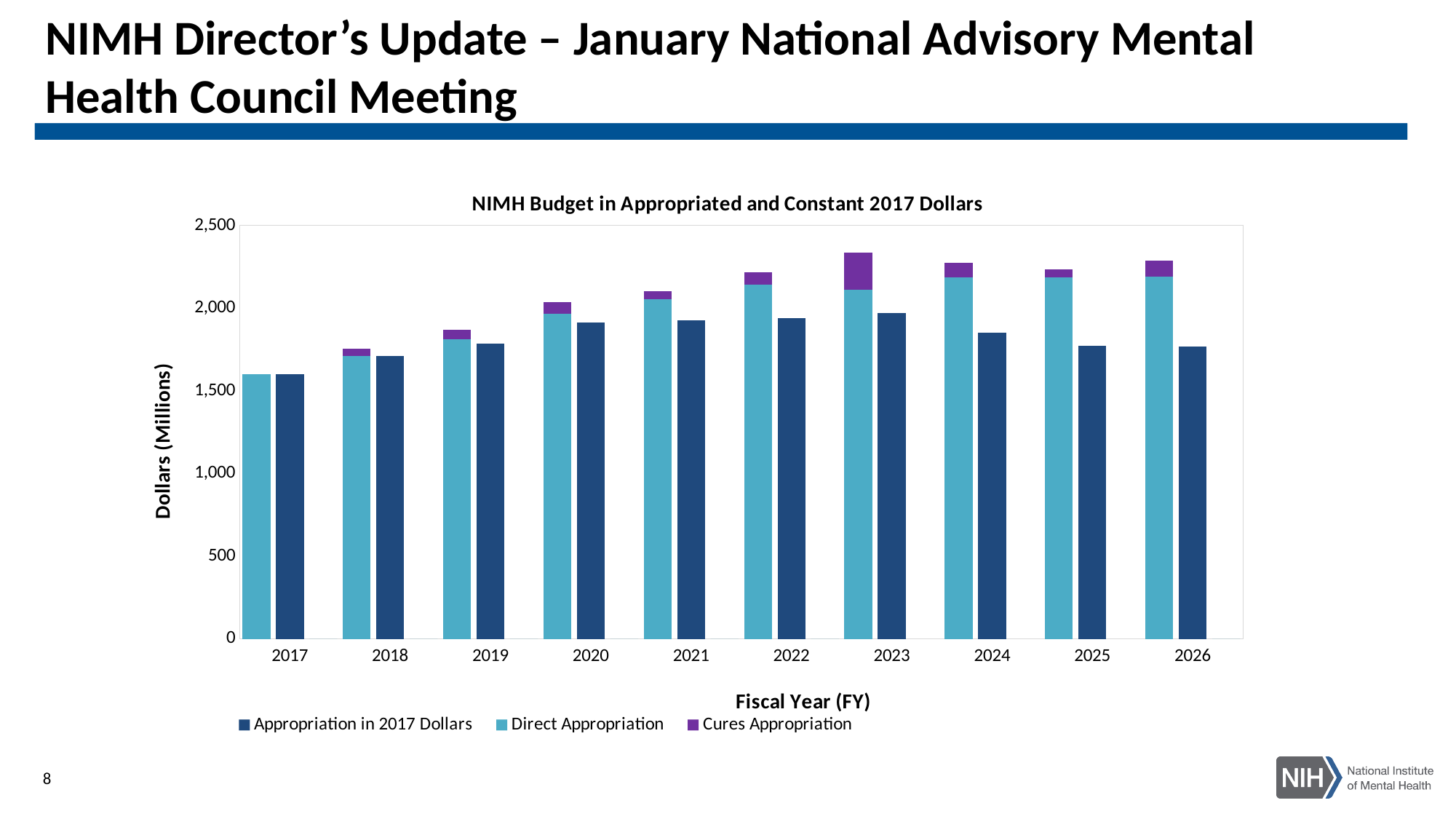
Which fiscal year has the largest Cures Appropriation? 2023 Does the Direct Appropriation rise or fall from 2017 to 2022? rise What is the title of the chart? NIMH Budget in Appropriated and Constant 2017 Dollars What kind of chart is shown on the slide? Bar chart How many fiscal years are shown on the x axis? 10 Is the Direct Appropriation for 2017 greater or less than 2,000? less Is the Direct Appropriation for 2022 greater or less than 2,000? greater How many series does the legend list? 3 Which fiscal year has the lowest Appropriation in 2017 Dollars? 2017 Which is larger, the Appropriation in 2017 Dollars for 2024 or for 2025? 2024 Is the Appropriation in 2017 Dollars for 2026 greater or less than 2,000? less What is the label of the y axis? Dollars (Millions)